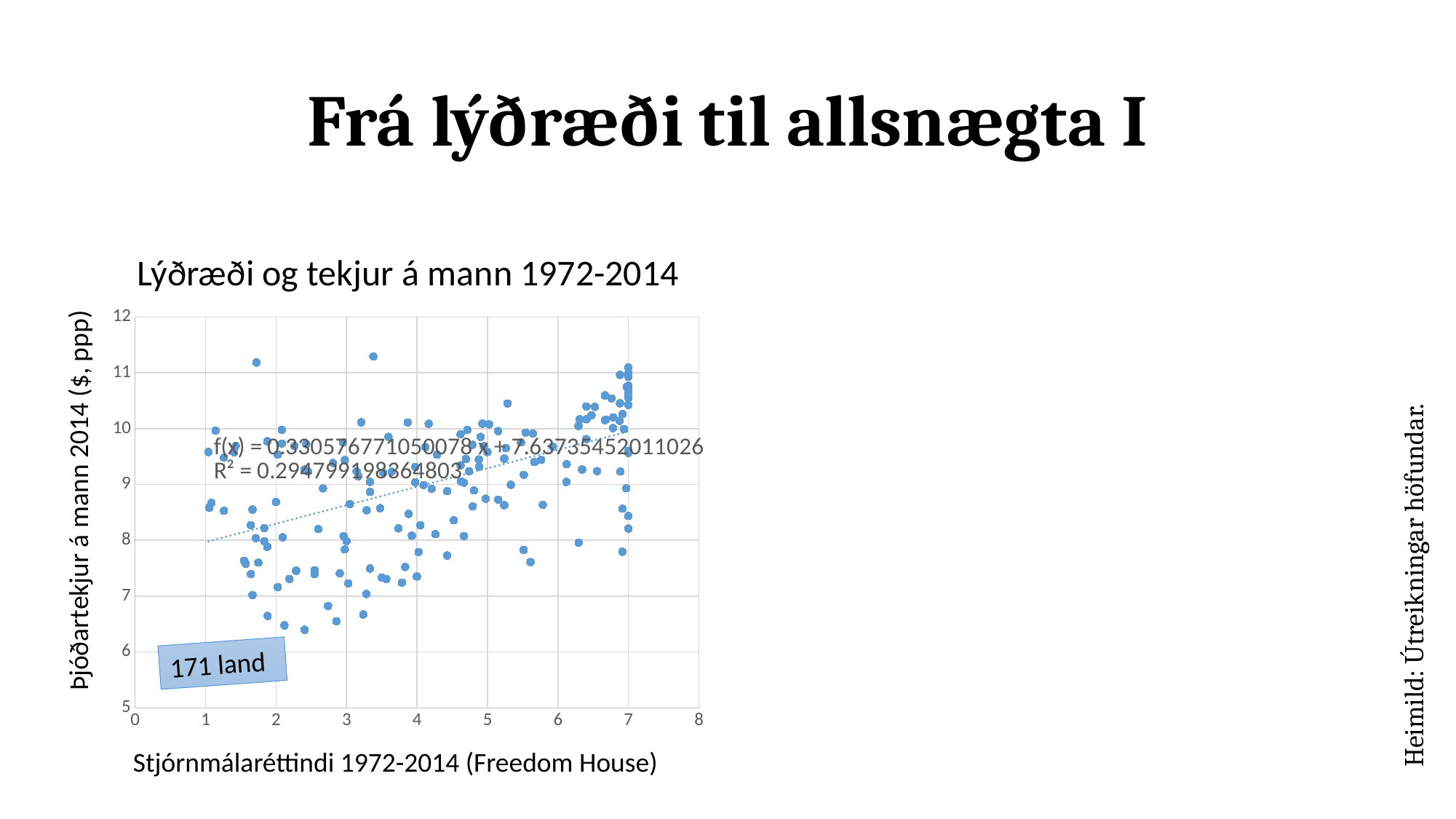
What is the slope of the fitted line f(x) shown on the chart? 0.330576771050078 What is the intercept of the fitted line f(x) shown on the chart? 7.63735452011026 What is the title of the chart? Lýðræði og tekjur á mann 1972-2014 How many countries does the label on the chart say are plotted? 171 What is the maximum value shown on the x axis? 8 Is the R² value of the trendline greater or less than 0.5? less According to the trendline, do the plotted values rise or fall as the x-axis value increases? Rise What kind of chart is shown on the slide? Scatter chart What is the R² value shown on the chart? 0.294799198364803 What is the label of the x axis? Stjórnmálaréttindi 1972-2014 (Freedom House) What is the maximum value shown on the y axis? 12